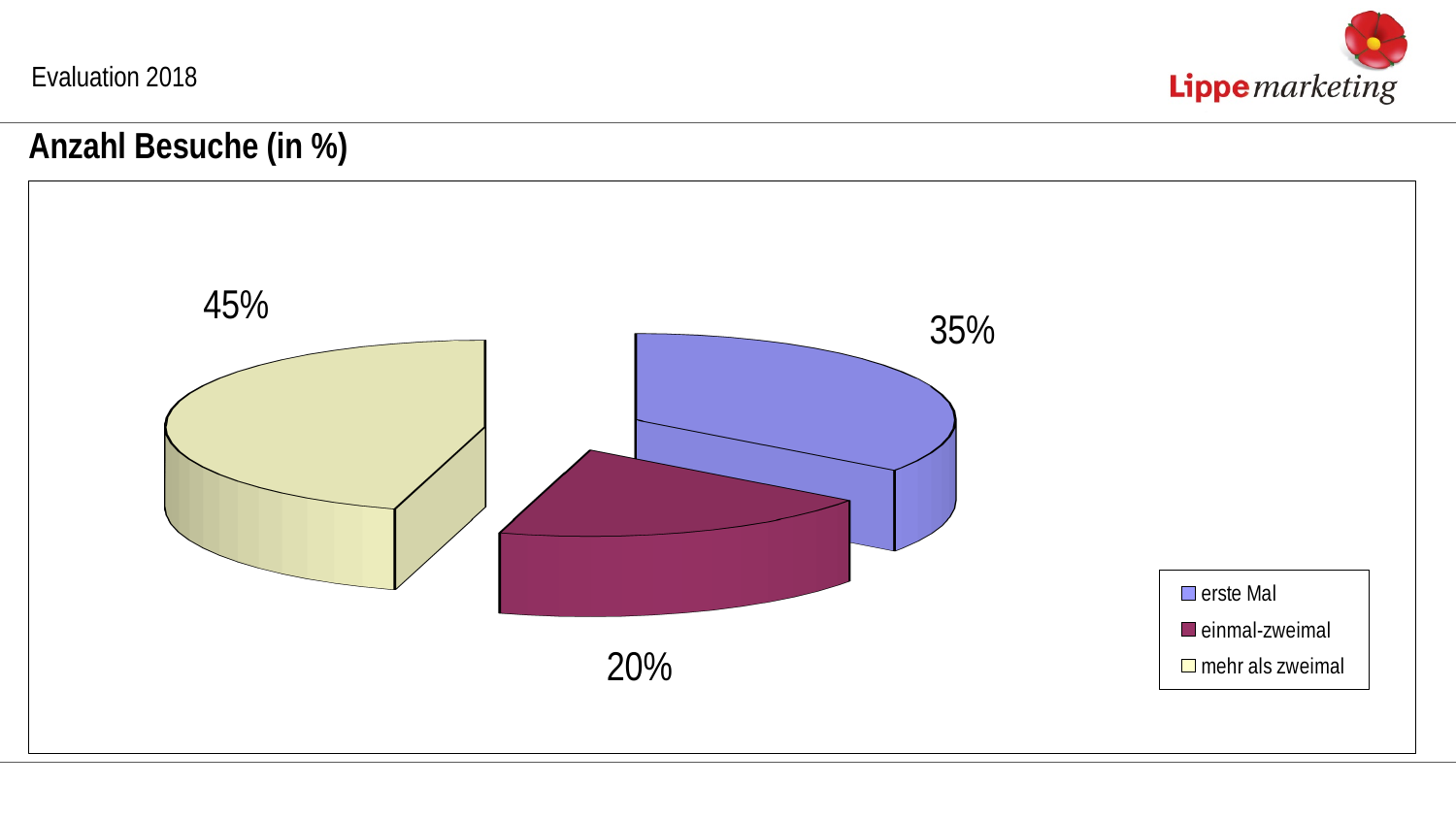
What is the share for "erste Mal"? 35% Which category has the smallest share of the pie? einmal-zweimal What is the difference in percentage points between "mehr als zweimal" and "erste Mal"? 10 What is the share for "mehr als zweimal"? 45% Which is larger, the share for "erste Mal" or for "einmal-zweimal"? erste Mal What is the title of the chart? Anzahl Besuche (in %) Which category has the largest share of the pie? mehr als zweimal What kind of chart is shown on the slide? pie chart What colour is the slice for "einmal-zweimal"? dark red What is the difference in percentage points between "erste Mal" and "einmal-zweimal"? 15 How many slices does the pie chart have? 3 What is the share for "einmal-zweimal"? 20%